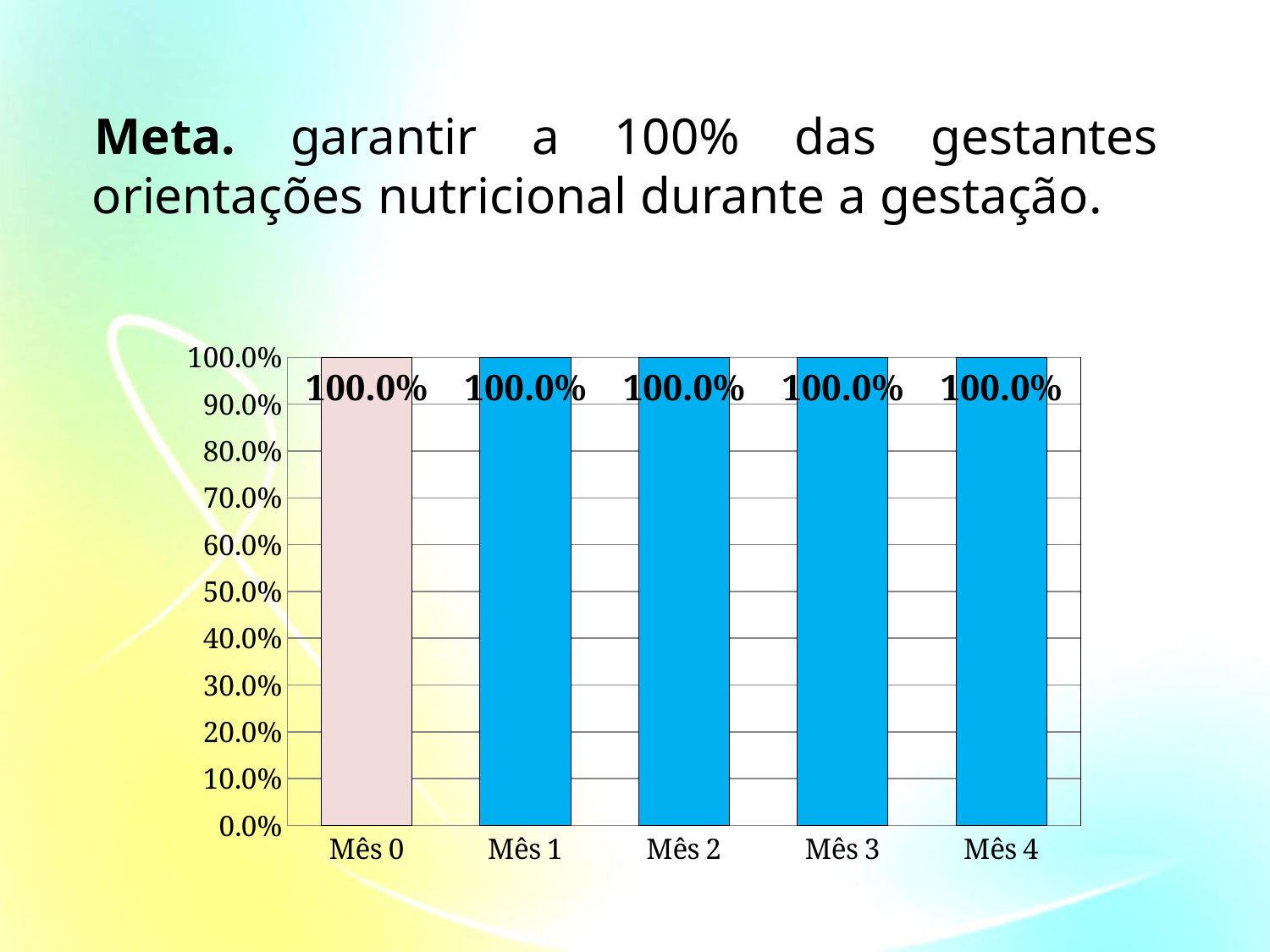
What is the value for Mês 2? 100.0% What is the difference between the values for Mês 1 and Mês 3? 0.0% Which bar is shown in a different colour from the others? Mês 0 What is the value for Mês 4? 100.0% How many categories are shown on the x axis? 5 Is the value for Mês 3 greater or less than 50.0%? greater What is the value for Mês 0? 100.0% What is the label of the first category on the x axis? Mês 0 Do the values rise, fall or stay the same from Mês 0 to Mês 4? stay the same What kind of chart is shown on the slide? bar chart